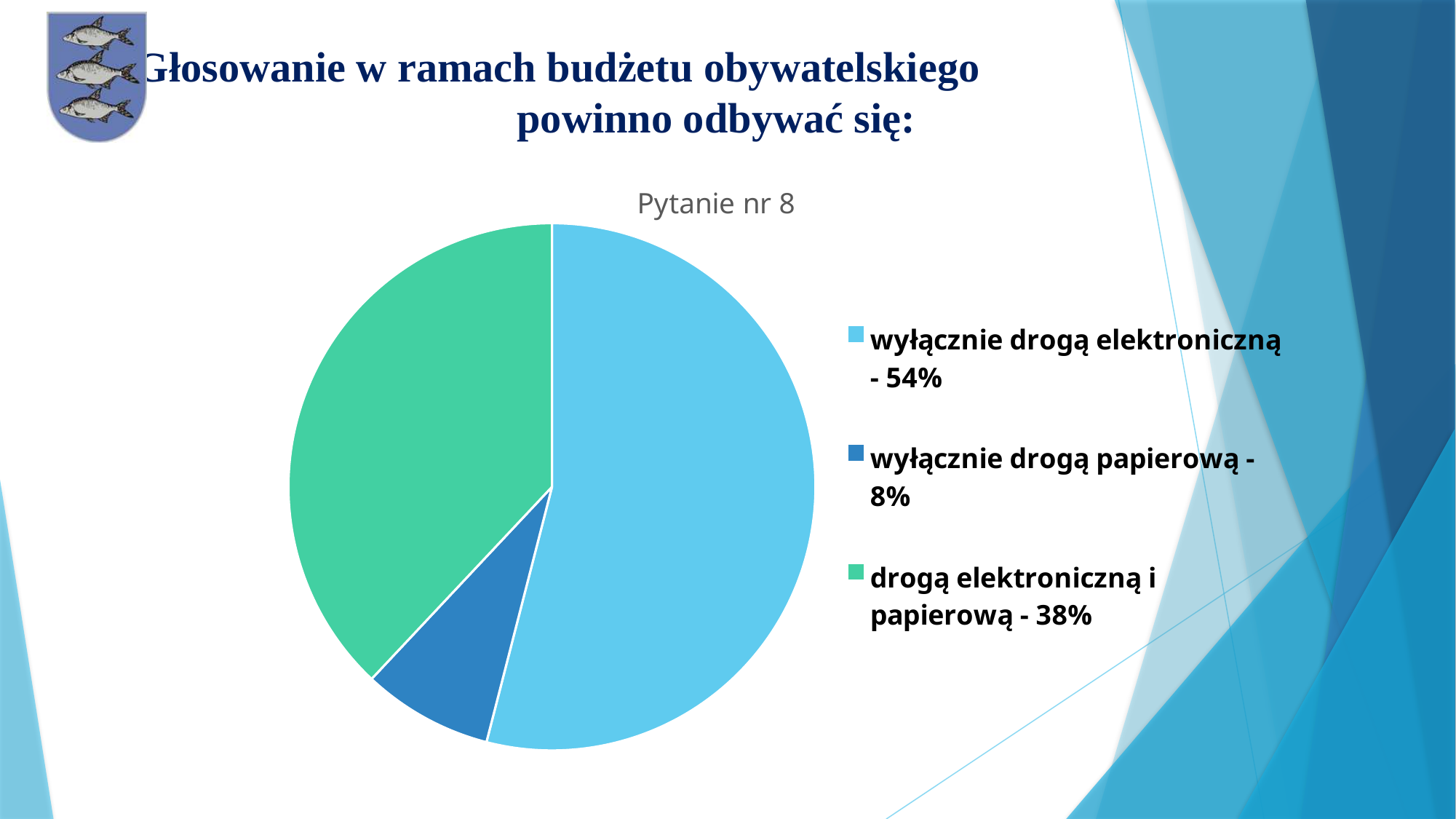
What is the difference in percentage points between 'wyłącznie drogą elektroniczną' and 'drogą elektroniczną i papierową'? 16 What colour is the slice for 'drogą elektroniczną i papierową'? green How many entries does the legend list? 3 What share of the pie is 'wyłącznie drogą elektroniczną'? 54% What share of the pie is 'drogą elektroniczną i papierową'? 38% Which category has the largest share of the pie? wyłącznie drogą elektroniczną Which is larger: the share for 'drogą elektroniczną i papierową' or for 'wyłącznie drogą papierową'? drogą elektroniczną i papierową What share of the pie is 'wyłącznie drogą papierową'? 8% What is the chart's title? Pytanie nr 8 What kind of chart is shown on the slide? pie chart Which category has the smallest share of the pie? wyłącznie drogą papierową How many slices does the pie chart have? 3